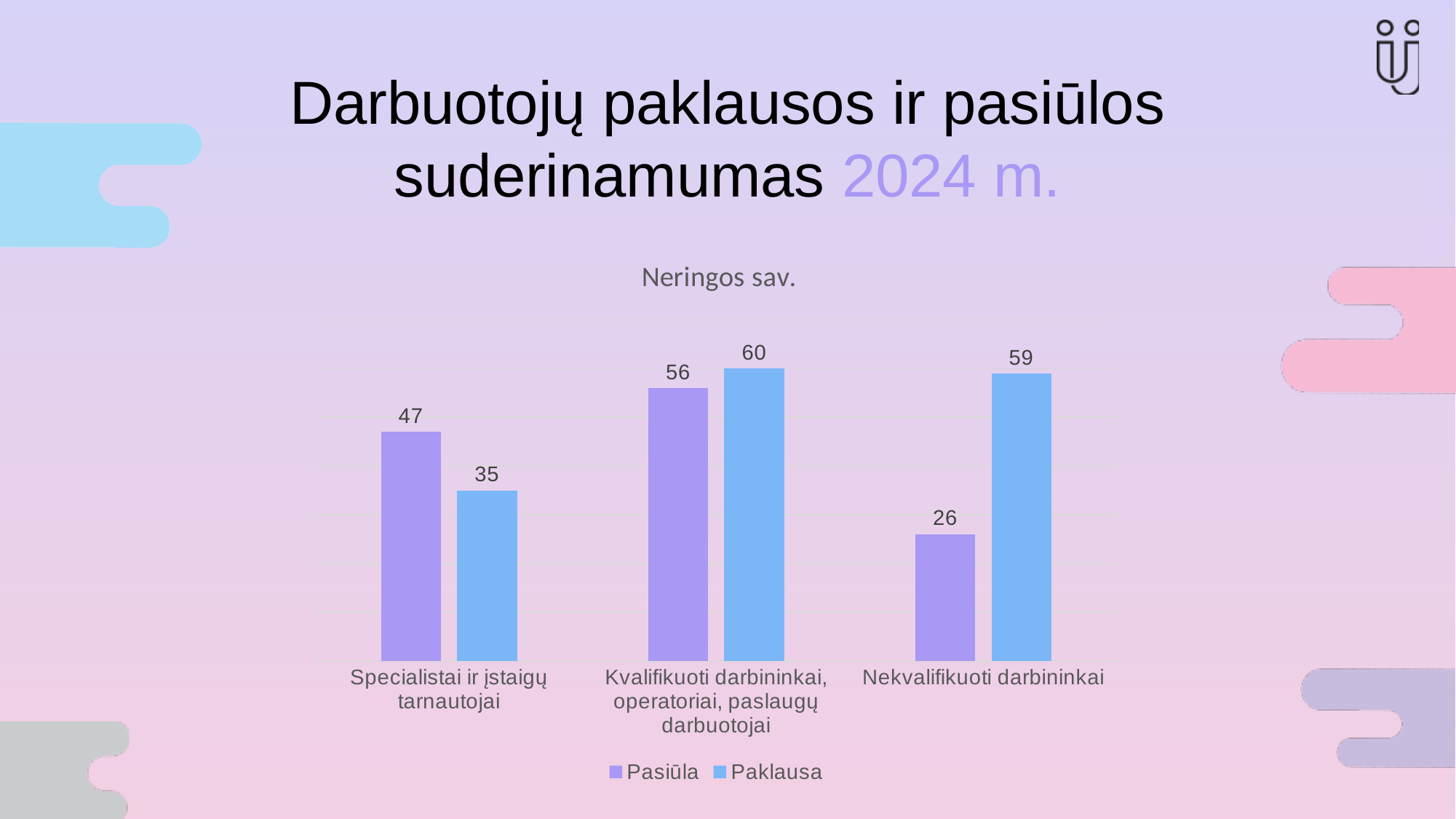
What is the title of the chart? Neringos sav. What is the difference between Paklausa and Pasiūla for Nekvalifikuoti darbininkai? 33 What is the difference between Pasiūla and Paklausa for Specialistai ir įstaigų tarnautojai? 12 What is the Pasiūla value for Specialistai ir įstaigų tarnautojai? 47 Which category has the highest Pasiūla value? Kvalifikuoti darbininkai, operatoriai, paslaugų darbuotojai What kind of chart is shown on the slide? Bar chart What is the Paklausa value for Kvalifikuoti darbininkai, operatoriai, paslaugų darbuotojai? 60 How many series does the legend list? 2 Which category has the lowest Paklausa value? Specialistai ir įstaigų tarnautojai For Kvalifikuoti darbininkai, operatoriai, paslaugų darbuotojai, which is larger: Pasiūla or Paklausa? Paklausa What is the Paklausa value for Nekvalifikuoti darbininkai? 59 How many categories are shown on the x axis? 3